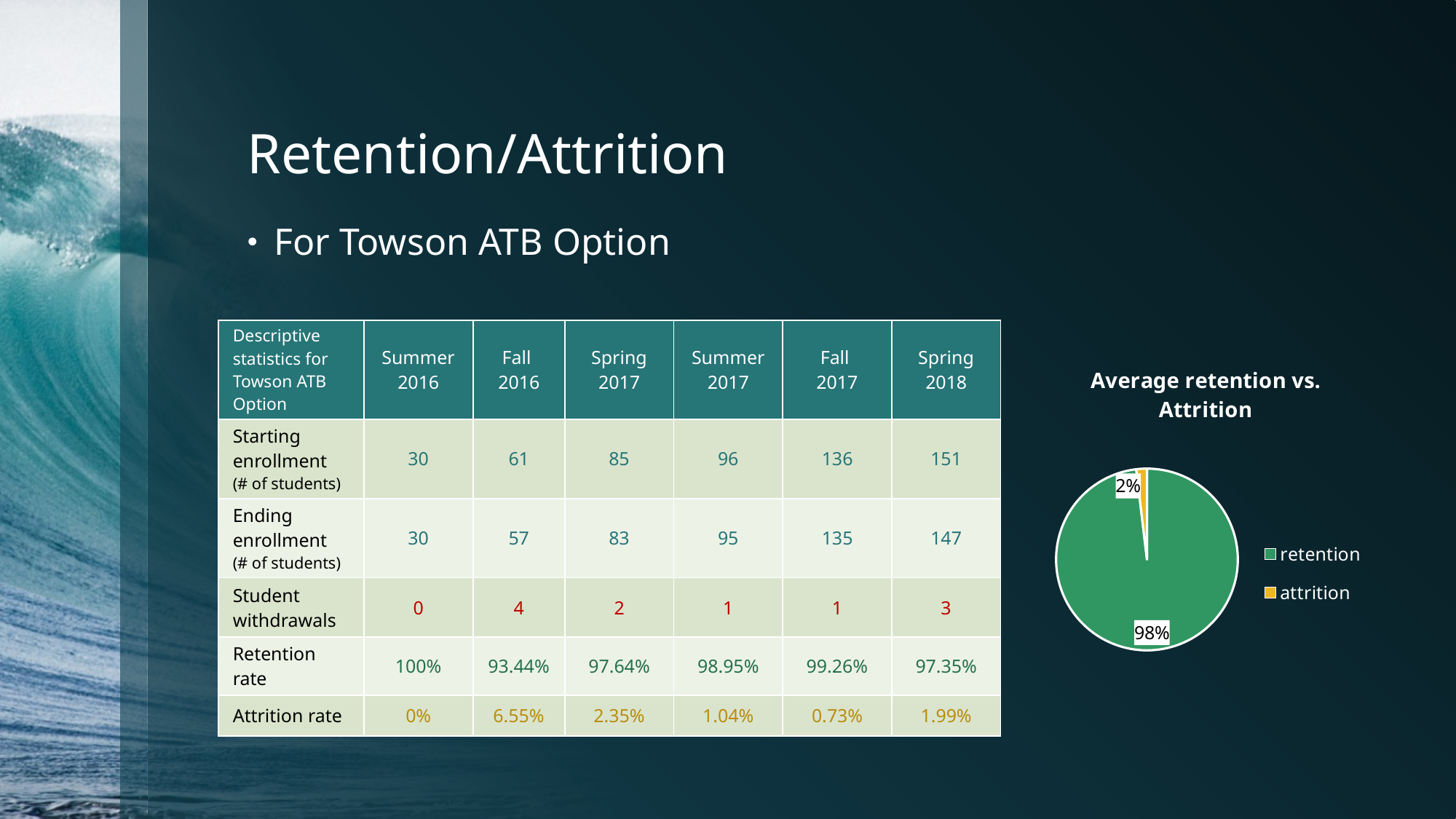
How many slices does the pie chart have? 2 Which is larger, the retention slice or the attrition slice? retention What is the title of the chart? Average retention vs. Attrition How many entries does the legend list? 2 Is the retention share greater or less than 50%? greater Which slice of the pie is the largest? retention What colour is the retention slice? green What share of the pie does attrition take? 2% What kind of chart is shown on the slide? pie chart What share of the pie does retention take? 98% What is the difference in percentage points between the retention and attrition slices? 96% Which slice of the pie is the smallest? attrition